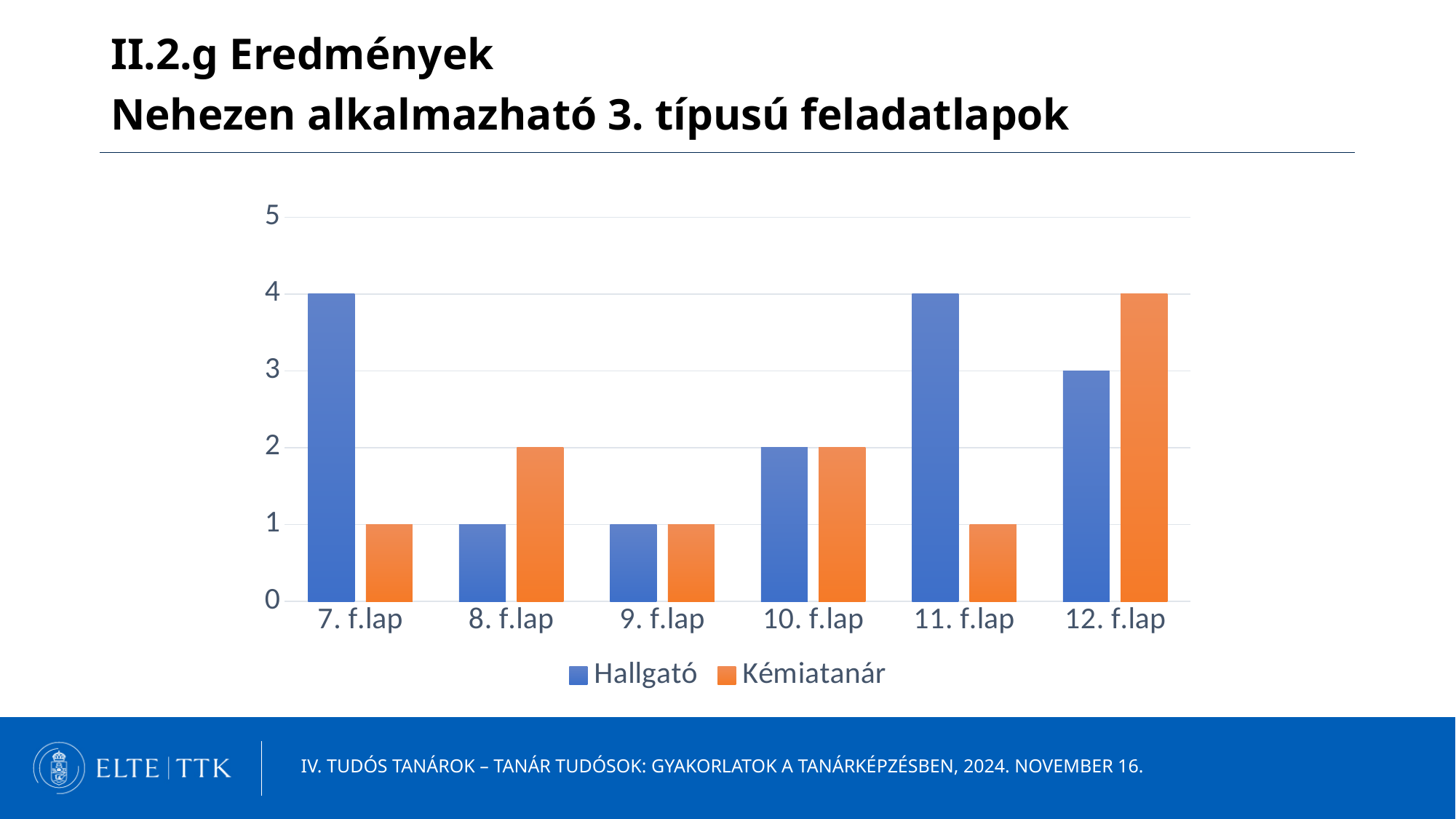
What is the Hallgató value for 7. f.lap? 4 Which category has the lowest Kémiatanár value, 8. f.lap or 11. f.lap? 11. f.lap How many series does the legend list? 2 What type of chart is shown on the slide? bar chart What is the difference between the Hallgató and Kémiatanár values for 7. f.lap? 3 Which is larger for 12. f.lap, the Hallgató value or the Kémiatanár value? Kémiatanár What is the Hallgató value for 12. f.lap? 3 Which series is shown in orange in the legend? Kémiatanár What is the Kémiatanár value for 8. f.lap? 2 How many categories are shown on the x axis? 6 What is the Kémiatanár value for 12. f.lap? 4 Which is larger for 11. f.lap, the Hallgató value or the Kémiatanár value? Hallgató